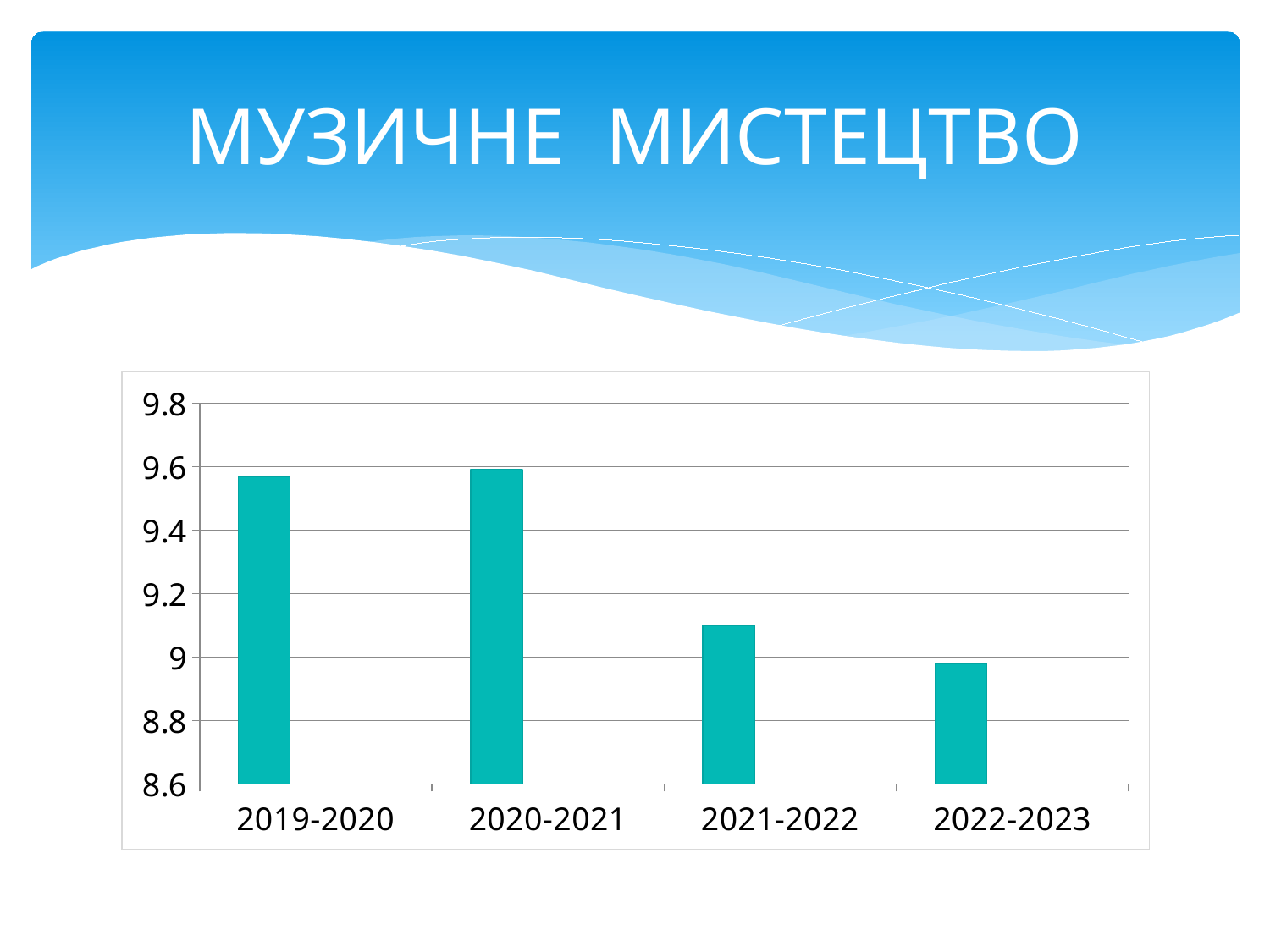
Is the value for 2021-2022 greater or less than 9? greater Which is larger, the value for 2021-2022 or the value for 2022-2023? 2021-2022 Is the value for 2021-2022 greater or less than 9.2? less What is the title shown at the top of the slide above the chart? МУЗИЧНЕ МИСТЕЦТВО How many categories (school years) are shown on the x axis of the chart? 4 Which school year has the lowest value in the chart? 2022-2023 Is the value for 2019-2020 greater or less than 9.4? greater Which is larger, the value for 2019-2020 or the value for 2021-2022? 2019-2020 What kind of chart is shown on the slide? bar chart Do the values generally rise or fall from 2019-2020 to 2022-2023? fall